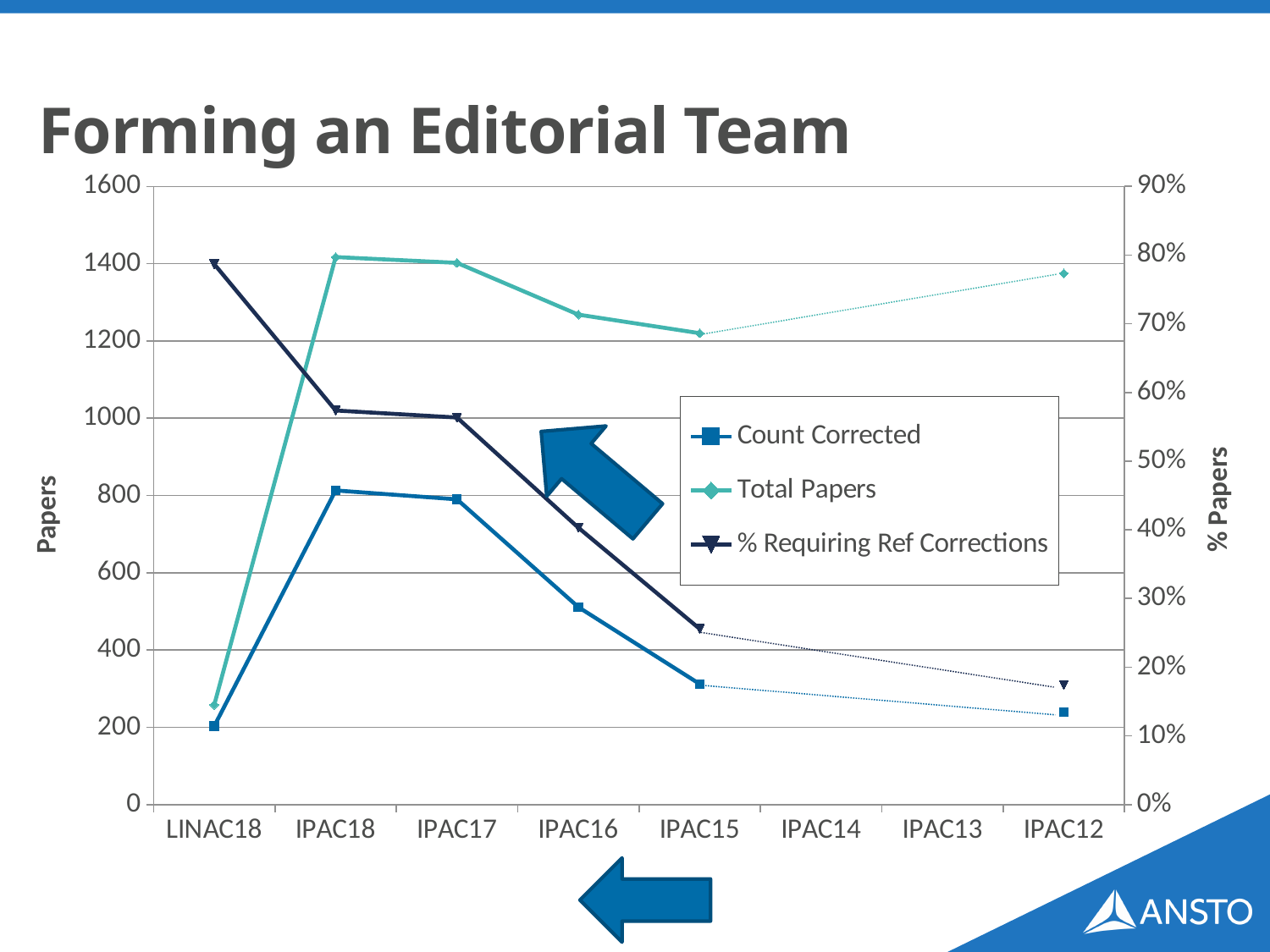
Is the value for % Requiring Ref Corrections at LINAC18 greater or less than 70%? greater How many categories are shown on the x axis? 8 Which is larger for Count Corrected: IPAC16 or IPAC15? IPAC16 At which category is % Requiring Ref Corrections highest? LINAC18 Is the value for Count Corrected at IPAC16 greater or less than 400? greater What is the title of the slide containing the chart? Forming an Editorial Team How many series does the legend list? 3 What is the label of the right-hand vertical axis? % Papers What kind of chart is shown on the slide? line chart Is the value for Total Papers at IPAC16 greater or less than 1200? greater At which category is Total Papers lowest? LINAC18